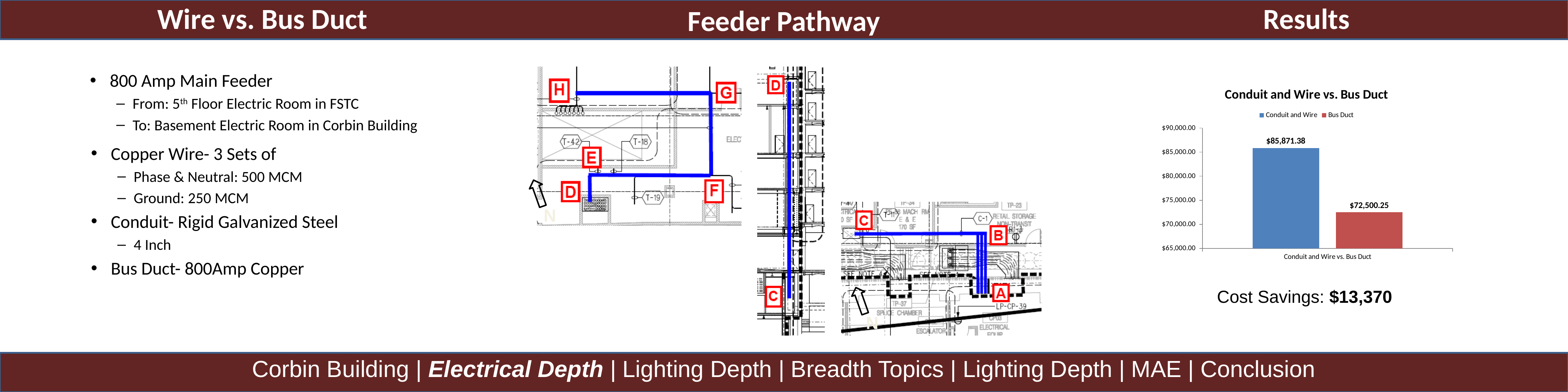
What is the value of the Conduit and Wire bar in the chart? $85,871.38 Is the value for Conduit and Wire greater or less than $80,000.00? greater What colour is the Bus Duct bar in the chart? red Is the value for Bus Duct greater or less than $75,000.00? less Which series has the lowest value in the chart? Bus Duct What is the value of the Bus Duct bar in the chart? $72,500.25 Which series has the highest value in the chart? Conduit and Wire Which series has the higher value in the chart, Conduit and Wire or Bus Duct? Conduit and Wire What kind of chart is shown on the slide? bar chart How many series does the chart legend list? 2 What is the difference between the Conduit and Wire value and the Bus Duct value in the chart? $13,371.13 What is the title of the chart? Conduit and Wire vs. Bus Duct